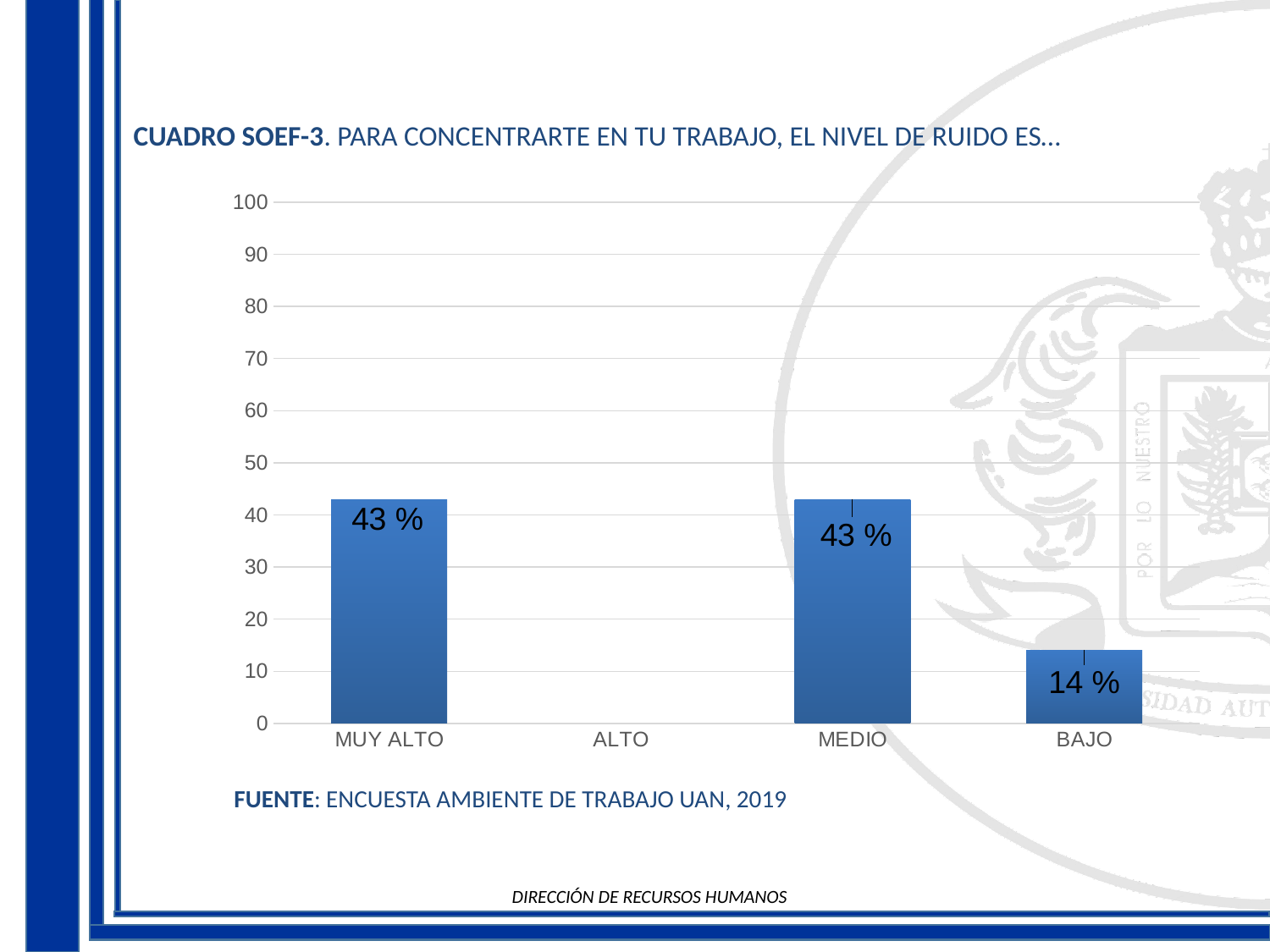
What is the maximum value shown on the y axis? 100 What is the difference between the values for MUY ALTO and BAJO? 29 % Is the value for MUY ALTO greater or less than 40? greater What source is cited below the chart? ENCUESTA AMBIENTE DE TRABAJO UAN, 2019 What is the value for MUY ALTO? 43 % Which category has the lowest value among the bars with data labels? BAJO What is the value for BAJO? 14 % What kind of chart is shown on the slide? bar chart How many categories are shown on the x axis? 4 Which is larger, the value for MEDIO or the value for BAJO? MEDIO What is the value for MEDIO? 43 % Is the value for BAJO greater or less than 20? less